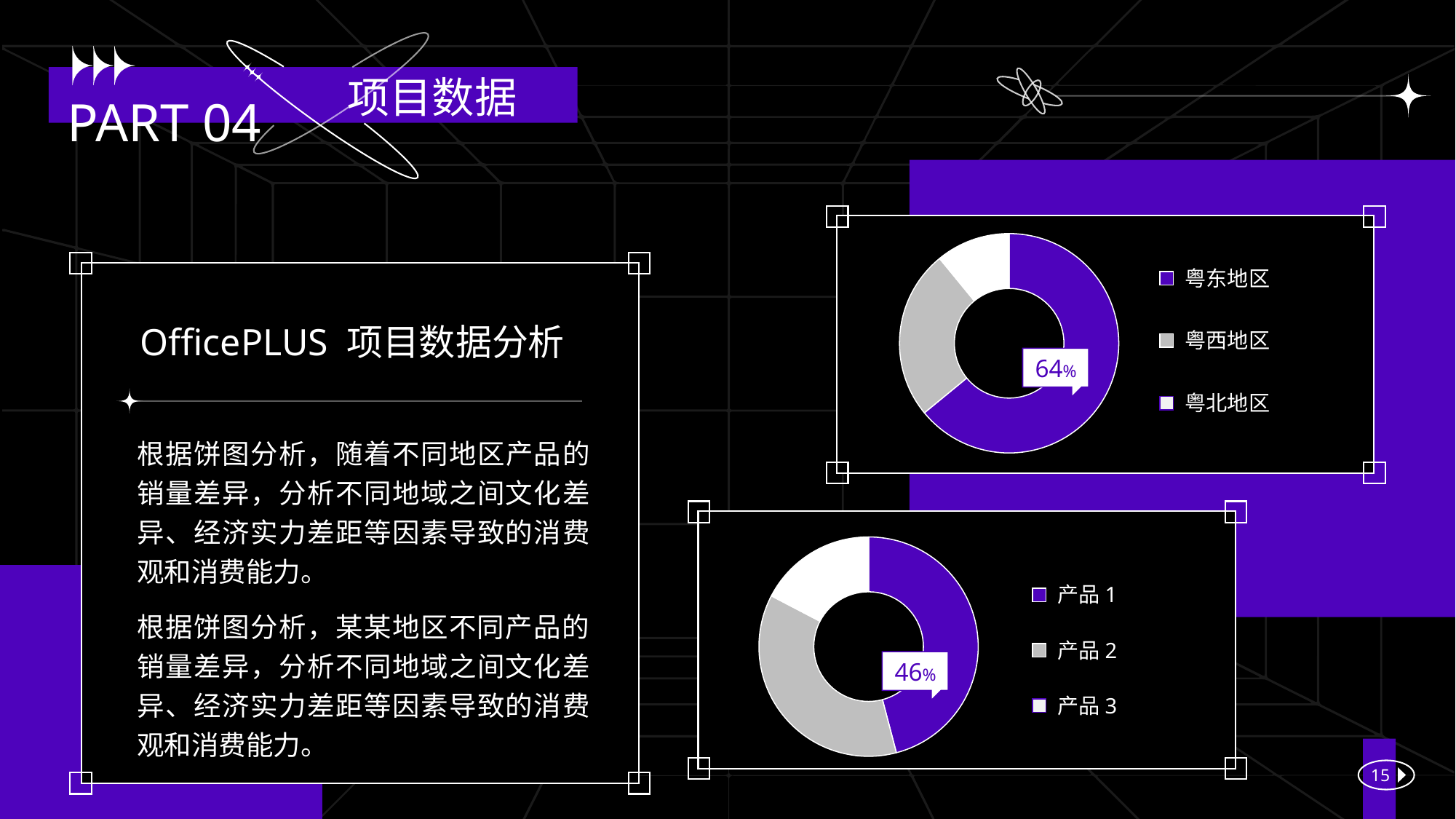
In the upper-right chart, which region has the largest share? 粤东地区 In the upper-right chart, which is larger, the share of 粤东地区 or 粤西地区? 粤东地区 In the upper-right chart, what colour represents 粤西地区? Gray In the upper-right chart, what is the value shown for 粤东地区? 64% In the upper-right chart, which region has the smallest share? 粤北地区 In the lower chart, which product has the smallest share? 产品 3 In the lower chart, which product has the largest share? 产品 1 In the lower chart, which is larger, the share of 产品 2 or 产品 3? 产品 2 How many categories does the upper-right chart show? 3 How many entries does the legend of the lower chart list? 3 In the lower chart, what is the value shown for 产品 1? 46% What kind of chart is the lower chart? Doughnut (pie) chart